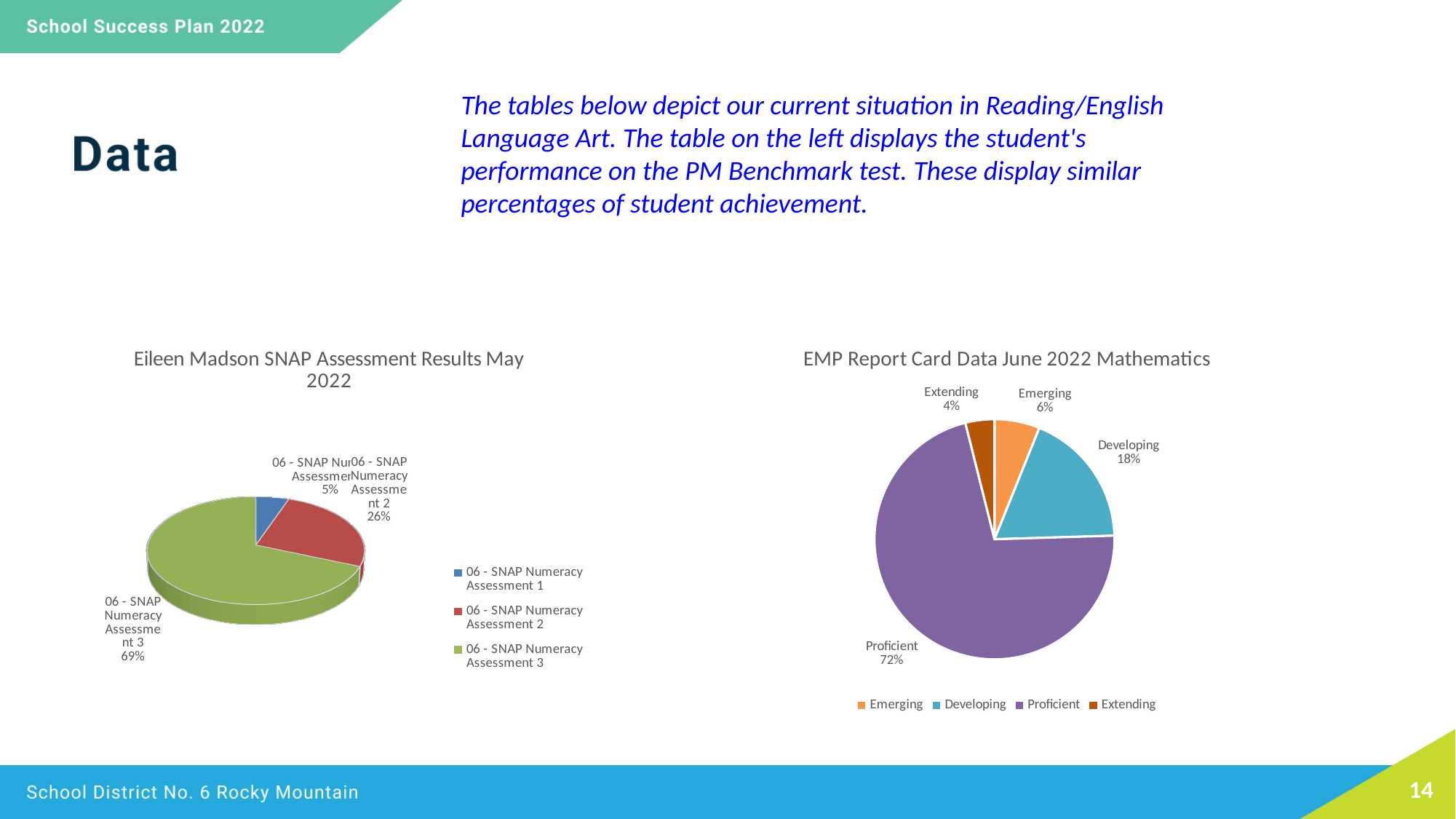
What type of chart is the 'EMP Report Card Data June 2022 Mathematics' chart? Pie chart In the 'EMP Report Card Data June 2022 Mathematics' chart, which category has the largest slice? Proficient In the 'EMP Report Card Data June 2022 Mathematics' chart, what is the difference in percentage points between Developing and Emerging? 12 In the 'Eileen Madson SNAP Assessment Results May 2022' chart, which slice is the smallest? 06 - SNAP Numeracy Assessment 1 In the 'Eileen Madson SNAP Assessment Results May 2022' chart, what colour is the 06 - SNAP Numeracy Assessment 2 slice? Red How many categories does the legend of the 'EMP Report Card Data June 2022 Mathematics' chart list? 4 In the 'EMP Report Card Data June 2022 Mathematics' chart, what share does Proficient have? 72% In the 'Eileen Madson SNAP Assessment Results May 2022' chart, what share does 06 - SNAP Numeracy Assessment 3 have? 69% In the 'EMP Report Card Data June 2022 Mathematics' chart, what share does Developing have? 18% In the 'Eileen Madson SNAP Assessment Results May 2022' chart, which is larger: 06 - SNAP Numeracy Assessment 2 or 06 - SNAP Numeracy Assessment 3? 06 - SNAP Numeracy Assessment 3 In the 'EMP Report Card Data June 2022 Mathematics' chart, which category has the smallest slice? Extending